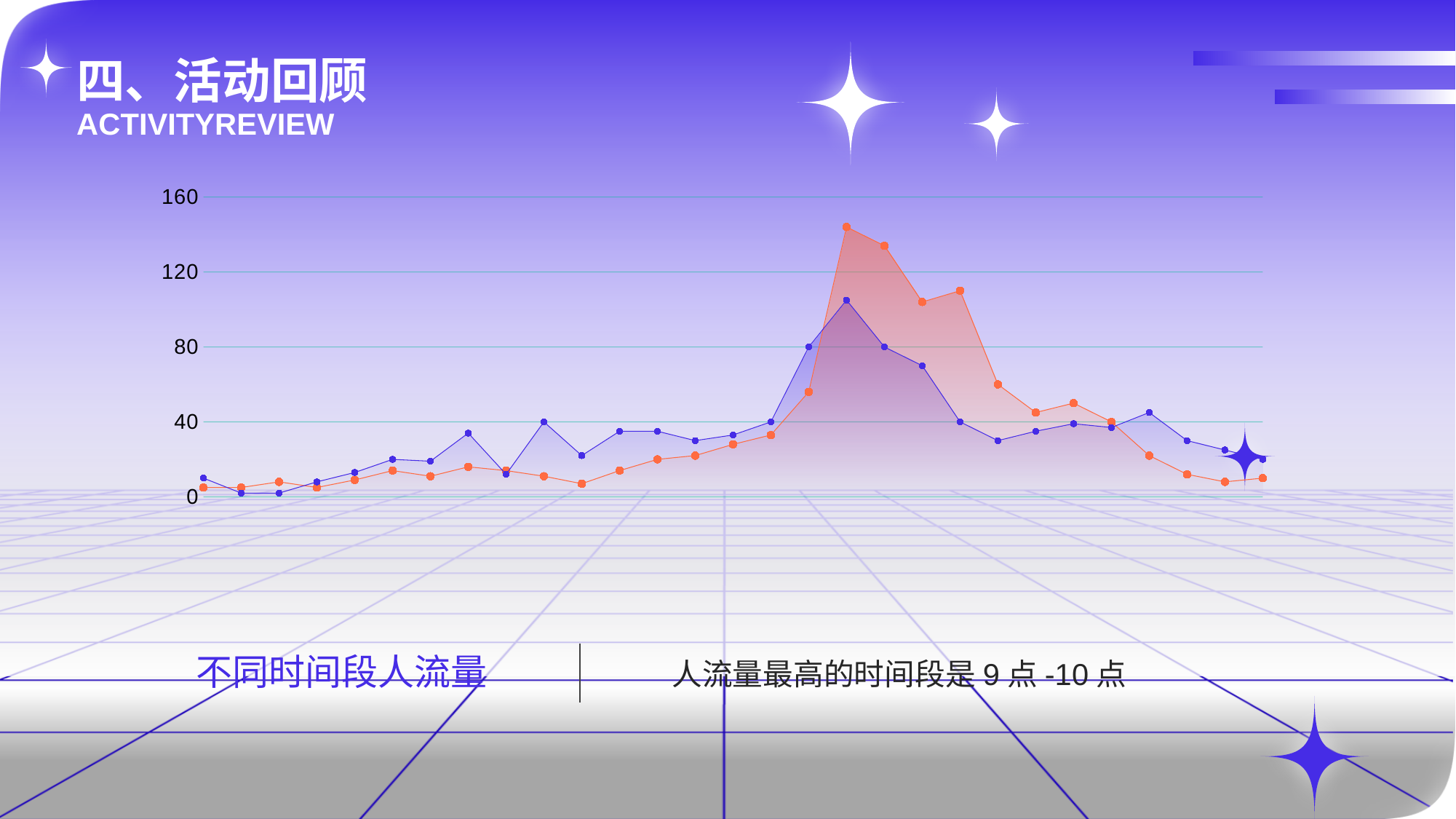
What is the highest tick value shown on the vertical axis? 160 Which series reaches the higher peak, the orange one or the blue one? orange After the peak, do the values of both series rise or fall toward the right end of the chart? fall Is the peak value of the orange series greater or less than 160? less According to the text on the slide, which time period has the highest foot traffic? 9 点 -10 点 What kind of chart is shown on the slide? area and line chart (lines with shaded areas beneath) Is the peak value of the blue series greater or less than 120? less How many data series are plotted on the chart? 2 Is the peak value of the orange series greater or less than 120? greater